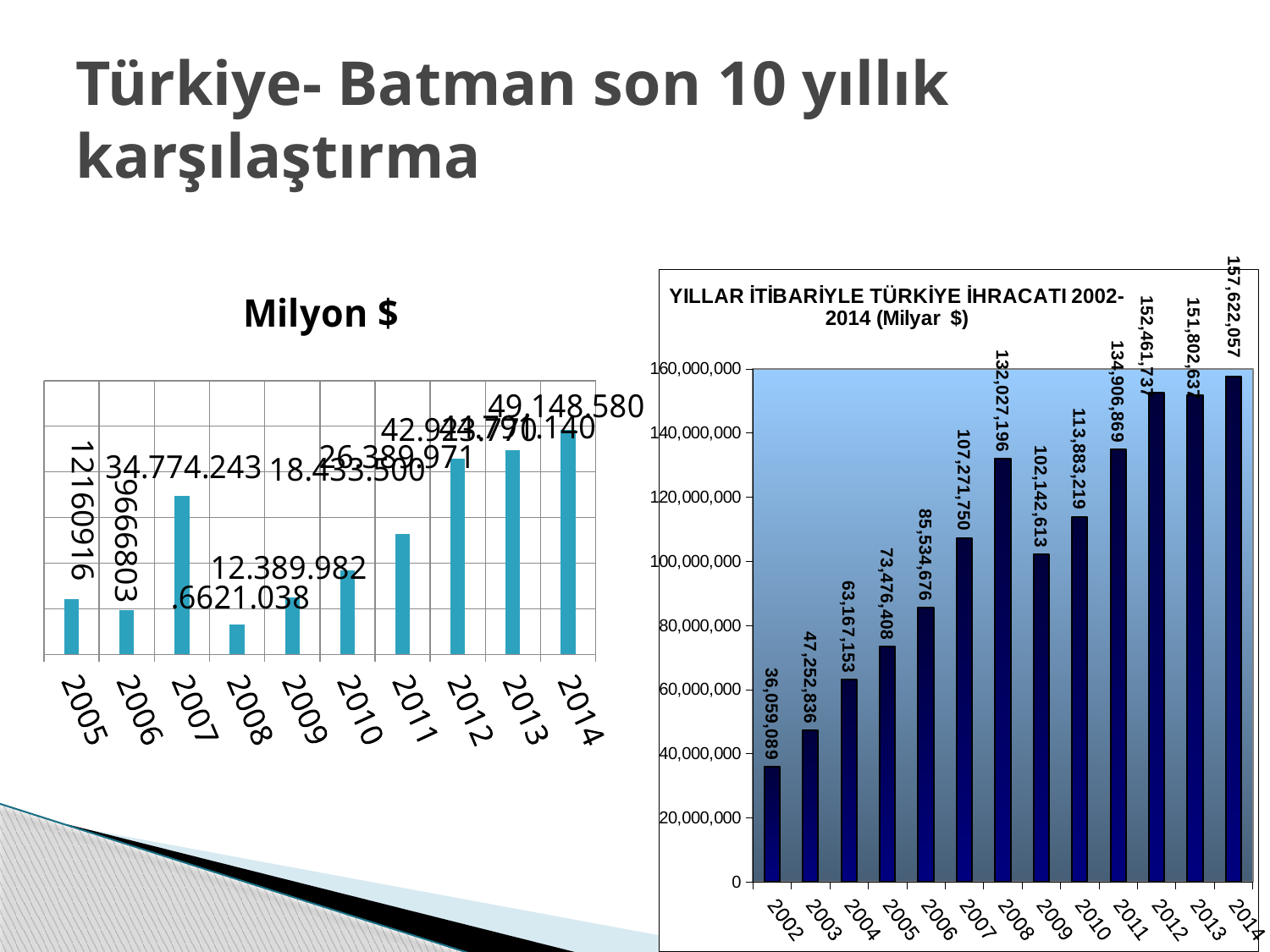
In the right chart (YILLAR İTİBARİYLE TÜRKİYE İHRACATI 2002-2014), what is the value for 2014? 157,622,057 In the left chart (Milyon $), how many years are shown on the x axis? 10 In the left chart (Milyon $), what is the value for 2014? 49.148.580 In the right chart (YILLAR İTİBARİYLE TÜRKİYE İHRACATI 2002-2014), how many years are shown? 13 In the right chart (YILLAR İTİBARİYLE TÜRKİYE İHRACATI 2002-2014), what is the difference between the values for 2014 and 2013? 5,819,420 In the left chart (Milyon $), which year has the highest value? 2014 In the right chart (YILLAR İTİBARİYLE TÜRKİYE İHRACATI 2002-2014), which year has the larger value, 2008 or 2009? 2008 In the right chart (YILLAR İTİBARİYLE TÜRKİYE İHRACATI 2002-2014), which year has the lowest value? 2002 In the right chart (YILLAR İTİBARİYLE TÜRKİYE İHRACATI 2002-2014), what is the value for 2009? 102,142,613 In the right chart (YILLAR İTİBARİYLE TÜRKİYE İHRACATI 2002-2014), which year has the highest value? 2014 What kind of chart is the right chart (YILLAR İTİBARİYLE TÜRKİYE İHRACATI 2002-2014)? Bar chart In the right chart (YILLAR İTİBARİYLE TÜRKİYE İHRACATI 2002-2014), what is the value for 2002? 36,059,089